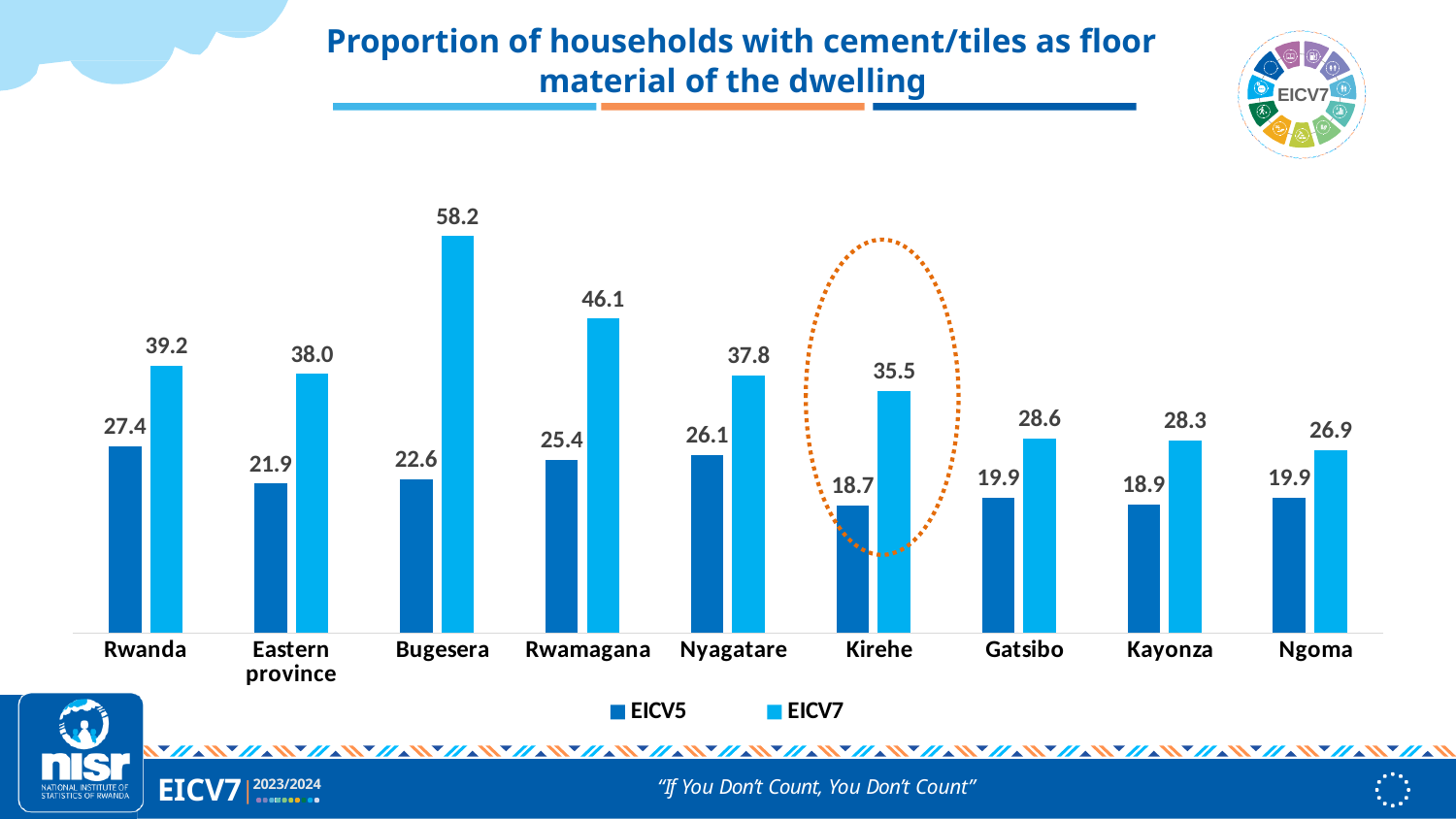
Which category is highlighted with a dotted orange circle? Kirehe What is the EICV7 value for Bugesera? 58.2 What is the EICV7 value for Eastern province? 38.0 What is the EICV5 value for Kirehe? 18.7 How many series does the legend list? 2 What is the difference between the EICV7 and EICV5 values for Rwamagana? 20.7 Which category has the highest EICV7 value? Bugesera Which category has the lowest EICV5 value? Kirehe How many categories are shown on the x axis? 9 What is the difference between the EICV7 values for Rwanda and Ngoma? 12.3 Which is larger, the EICV7 value for Nyagatare or the EICV7 value for Kirehe? Nyagatare What kind of chart is shown on the slide? Bar chart